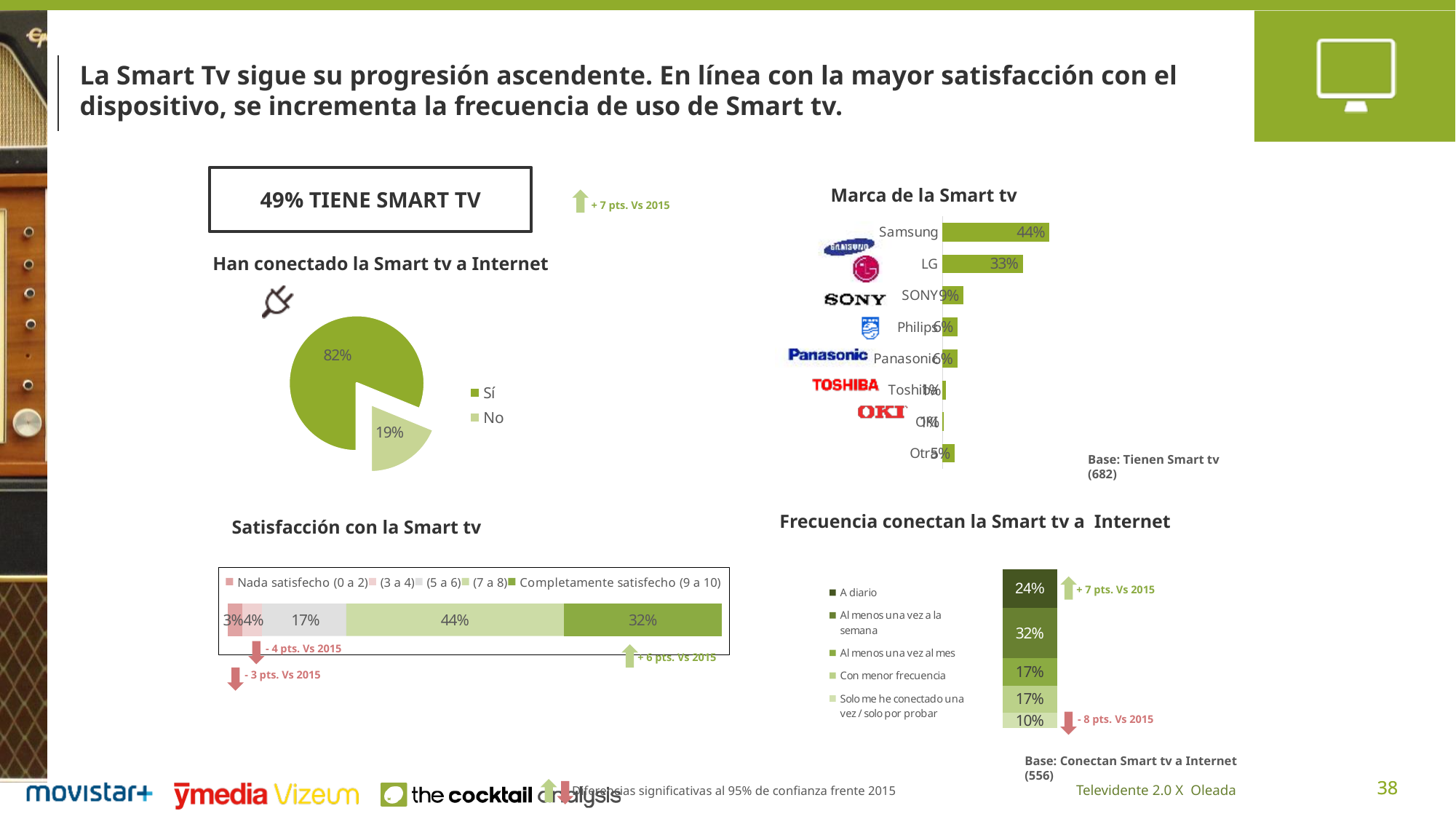
In the 'Han conectado la Smart tv a Internet' pie chart, what percentage answered 'Sí'? 82% In the 'Marca de la Smart tv' chart, what is the difference between Samsung and LG? 11 percentage points In the 'Marca de la Smart tv' chart, which brand has the highest value? Samsung What kind of chart is 'Han conectado la Smart tv a Internet'? Pie chart In the 'Marca de la Smart tv' chart, what is the value for Samsung? 44% In the 'Marca de la Smart tv' chart, what is the value for LG? 33% In the 'Marca de la Smart tv' chart, which is larger, LG or SONY? LG What kind of chart is 'Marca de la Smart tv'? Bar chart In the 'Han conectado la Smart tv a Internet' pie chart, what percentage answered 'No'? 19% In the 'Frecuencia conectan la Smart tv a Internet' chart, what percentage is 'Al menos una vez a la semana'? 32% In the 'Satisfacción con la Smart tv' chart, what percentage is 'Completamente satisfecho (9 a 10)'? 32% In the 'Satisfacción con la Smart tv' chart, how many categories does the legend list? 5